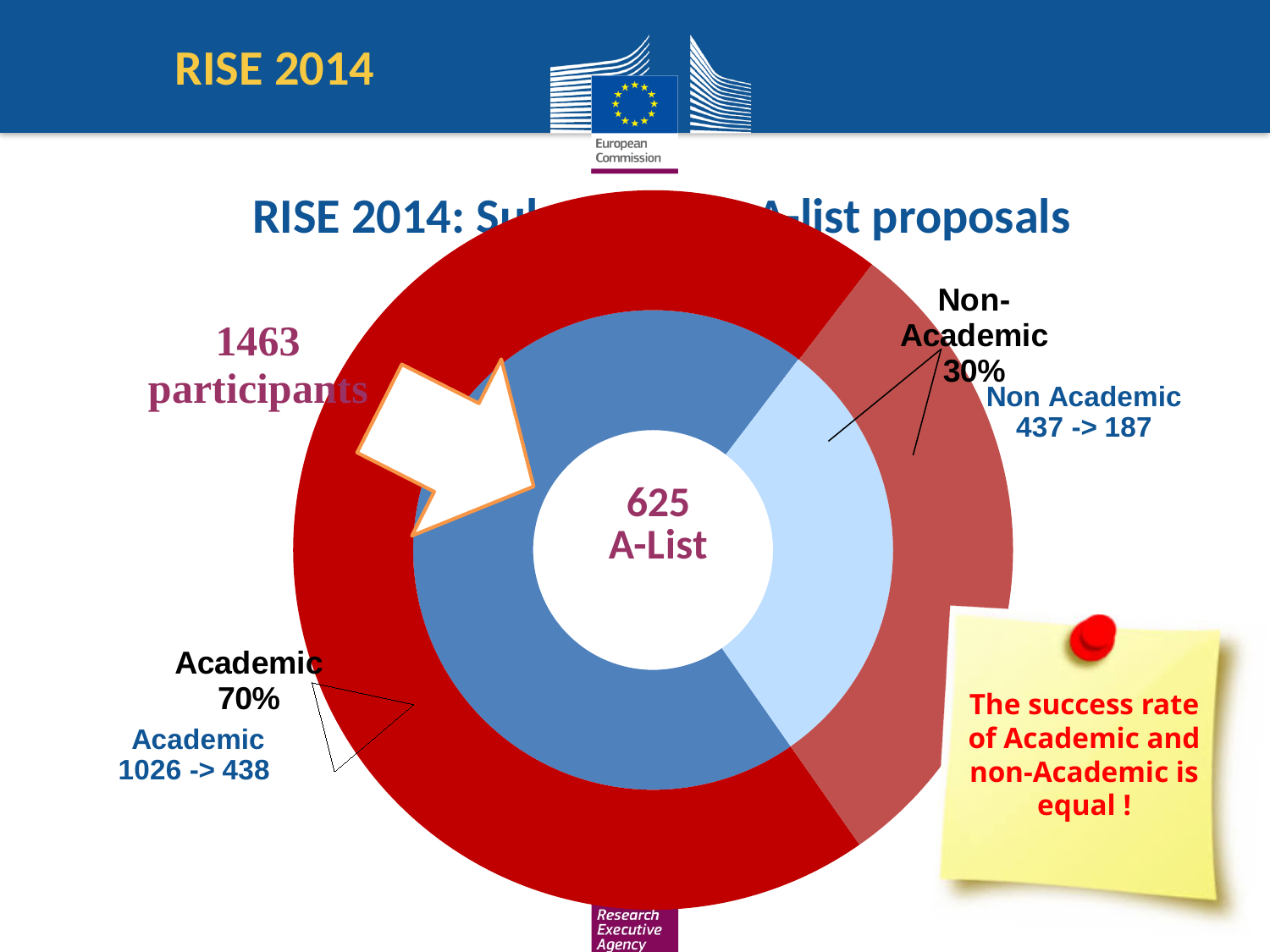
What percentage share of the doughnut chart is labelled Non-Academic? 30% By how many percentage points does the Academic share exceed the Non-Academic share? 40 percentage points According to the label, what are the Non Academic figures shown? 437 -> 187 Which category has the larger share in the chart, Academic or Non-Academic? Academic How many categories does the doughnut chart show? 2 What percentage share of the doughnut chart is labelled Academic? 70% According to the label, how many Academic proposals were there before and after the arrow (1026 -> ?)? 1026 -> 438 How many participants does the label to the left of the chart state? 1463 participants What kind of chart is shown on the slide? Doughnut (pie) chart Which category has the smallest share in the chart? Non-Academic What does the yellow sticky note on the slide say about the success rates? The success rate of Academic and non-Academic is equal ! What number is printed in the centre of the chart? 625 A-List